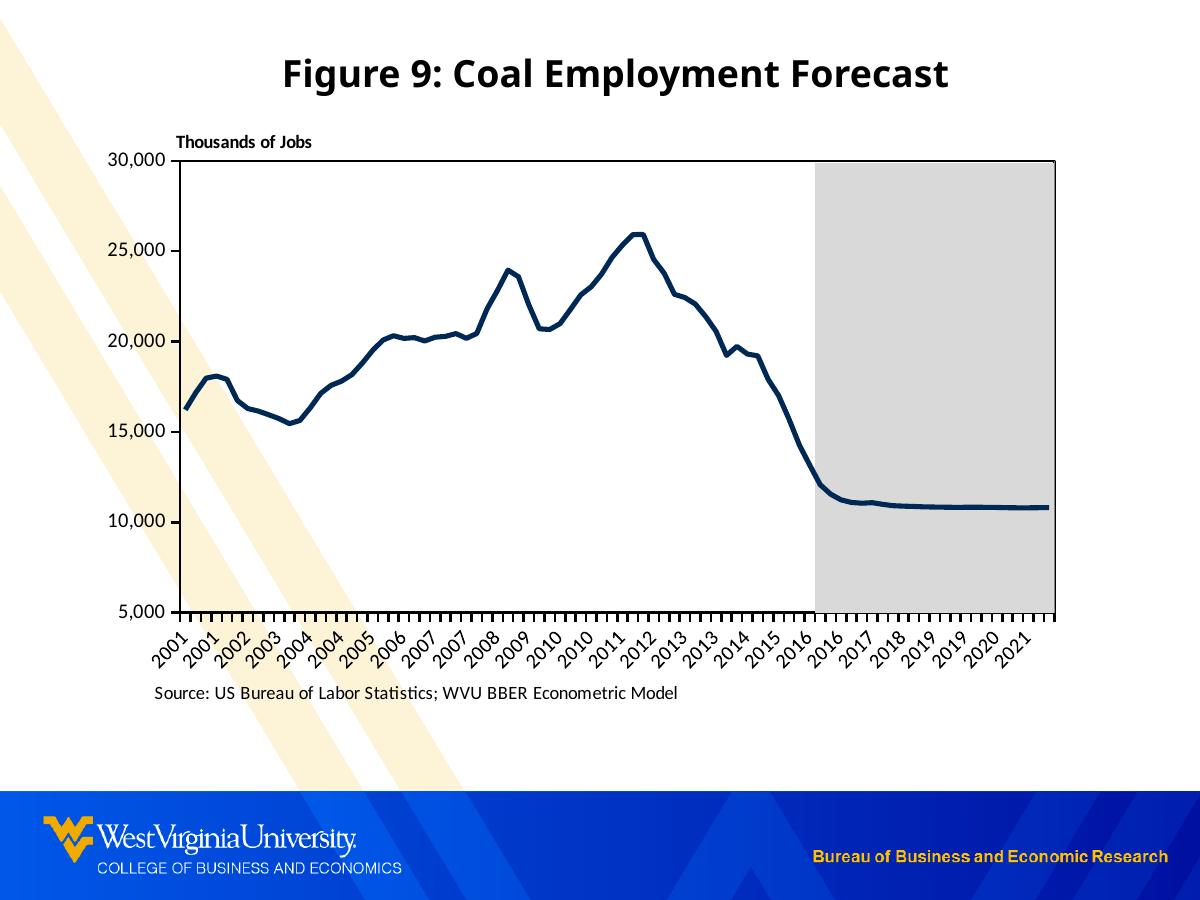
Is the highest value reached around 2011-2012 greater or less than 20,000? greater What type of chart is shown on the slide? Line chart Is the value at the start of the series in 2001 greater or less than 20,000? less What unit is shown on the vertical axis label of the chart? Thousands of Jobs Is the value at the end of the forecast in 2021 greater or less than 15,000? less Does coal employment rise or fall between 2003 and 2008? rise Which is higher, the value in 2001 or the value in 2021? 2001 What is the title of the chart? Figure 9: Coal Employment Forecast Which is higher, the peak around 2008 or the peak around 2012? The peak around 2012 Does coal employment rise or fall between 2012 and 2016? fall